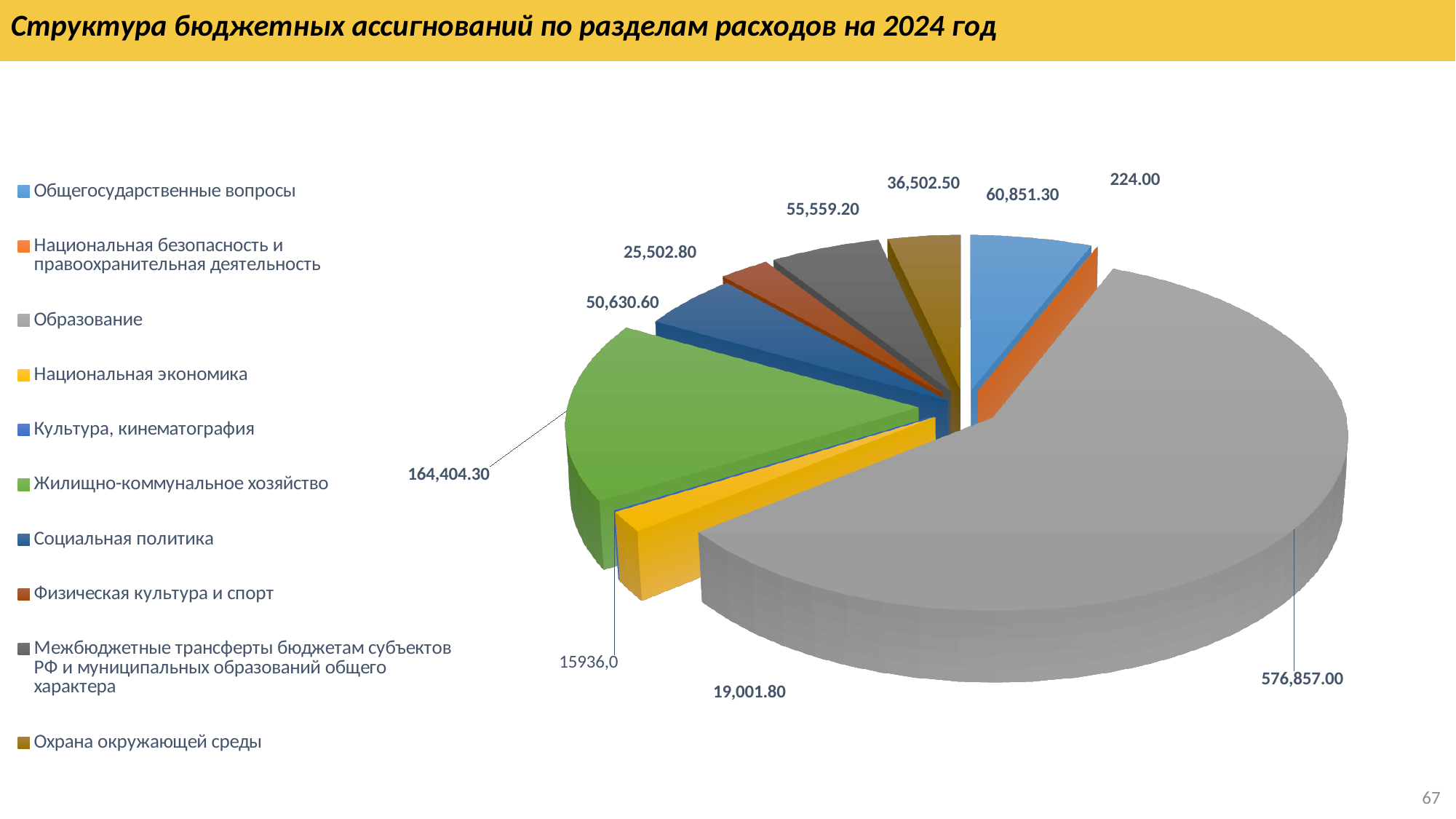
What is the title of the slide? Структура бюджетных ассигнований по разделам расходов на 2024 год How many categories does the pie chart show? 10 What kind of chart is shown on the slide? pie chart Which is larger: Жилищно-коммунальное хозяйство or Общегосударственные вопросы? Жилищно-коммунальное хозяйство What is the value for Социальная политика? 50,630.60 Which category has the smallest value? Национальная безопасность и правоохранительная деятельность What is the value for Охрана окружающей среды? 36,502.50 Which category has the largest value? Образование What colour is the slice for Жилищно-коммунальное хозяйство? green What is the value for Жилищно-коммунальное хозяйство? 164,404.30 What is the value for Образование? 576,857.00 What is the difference between the values for Общегосударственные вопросы and Социальная политика? 10,220.70